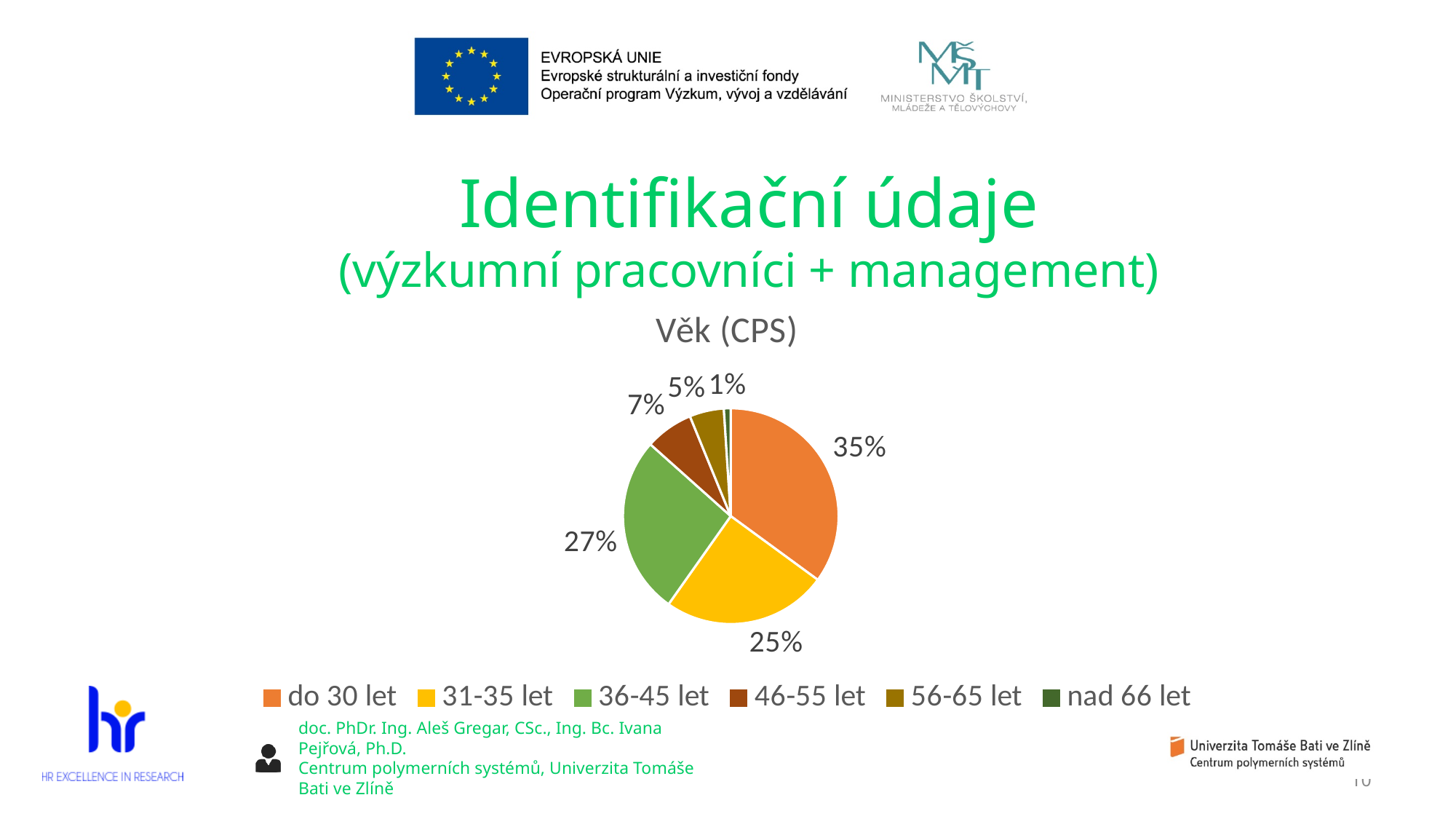
What share of the pie does the '36-45 let' slice represent? 27% What share of the pie does the '31-35 let' slice represent? 25% How many categories does the pie chart have? 6 What share of the pie does the 'nad 66 let' slice represent? 1% What is the difference in percentage points between the '36-45 let' and '31-35 let' slices? 2% Which age category has the largest share of the pie? do 30 let Which is larger, the share for '46-55 let' or the share for '56-65 let'? 46-55 let What type of chart is shown on the slide? pie chart What is the title of the chart? Věk (CPS) Which age category has the smallest share of the pie? nad 66 let